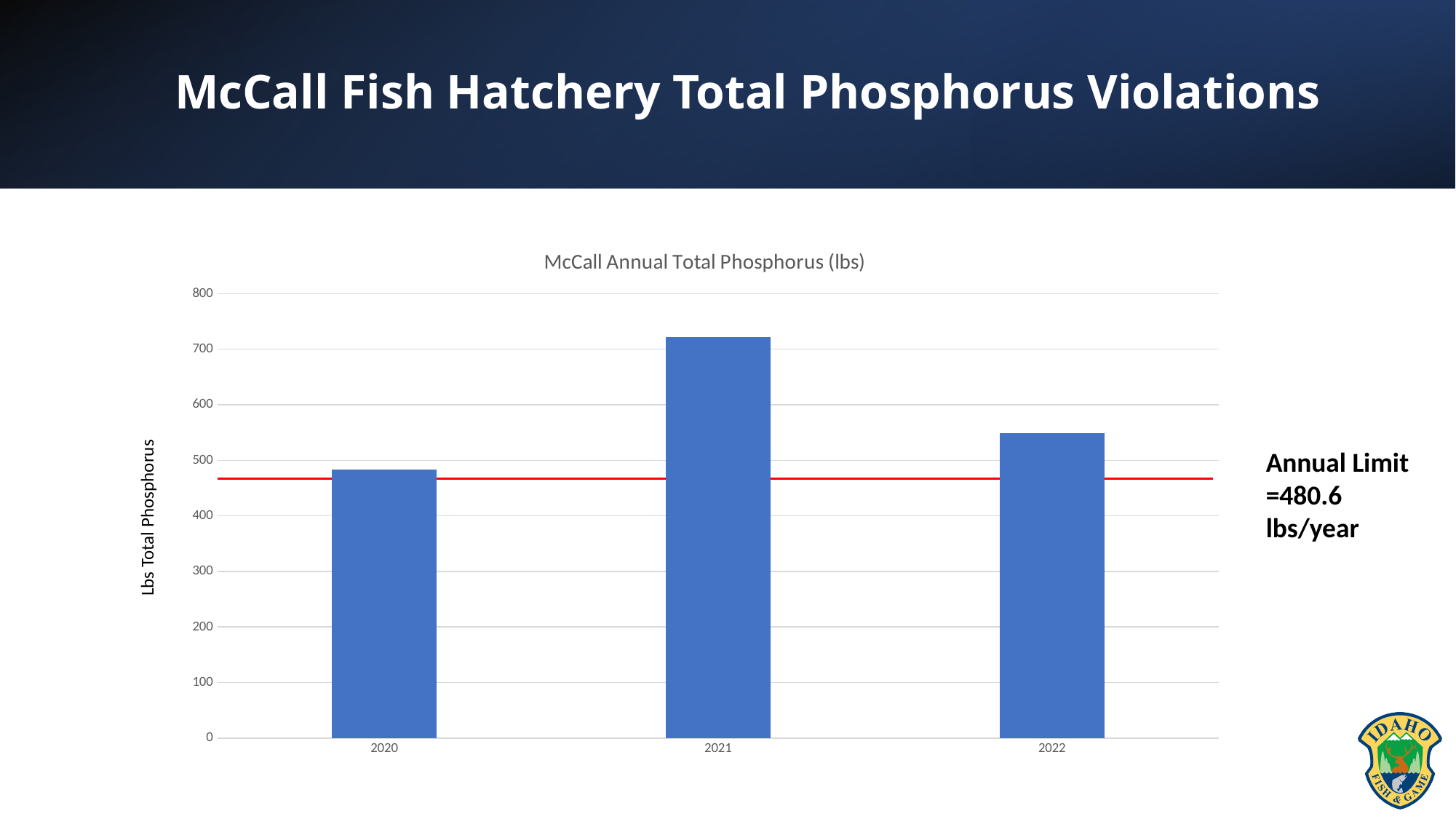
Is the value for 2021 greater or less than 700? greater Which year has the lowest total phosphorus in the chart? 2020 Do the total phosphorus values rise steadily from 2020 to 2022? No, they rise from 2020 to 2021 and then fall in 2022 How many years are plotted in the McCall Annual Total Phosphorus chart? 3 What annual limit does the red line on the chart represent, according to the slide text? 480.6 lbs/year Is the value for 2022 greater or less than 500? greater Which year has the larger total phosphorus value, 2020 or 2022? 2022 Is the value for 2022 greater or less than 600? less Which year has the highest total phosphorus in the chart? 2021 What kind of chart is shown on the slide? bar chart What is the title of the chart? McCall Annual Total Phosphorus (lbs)